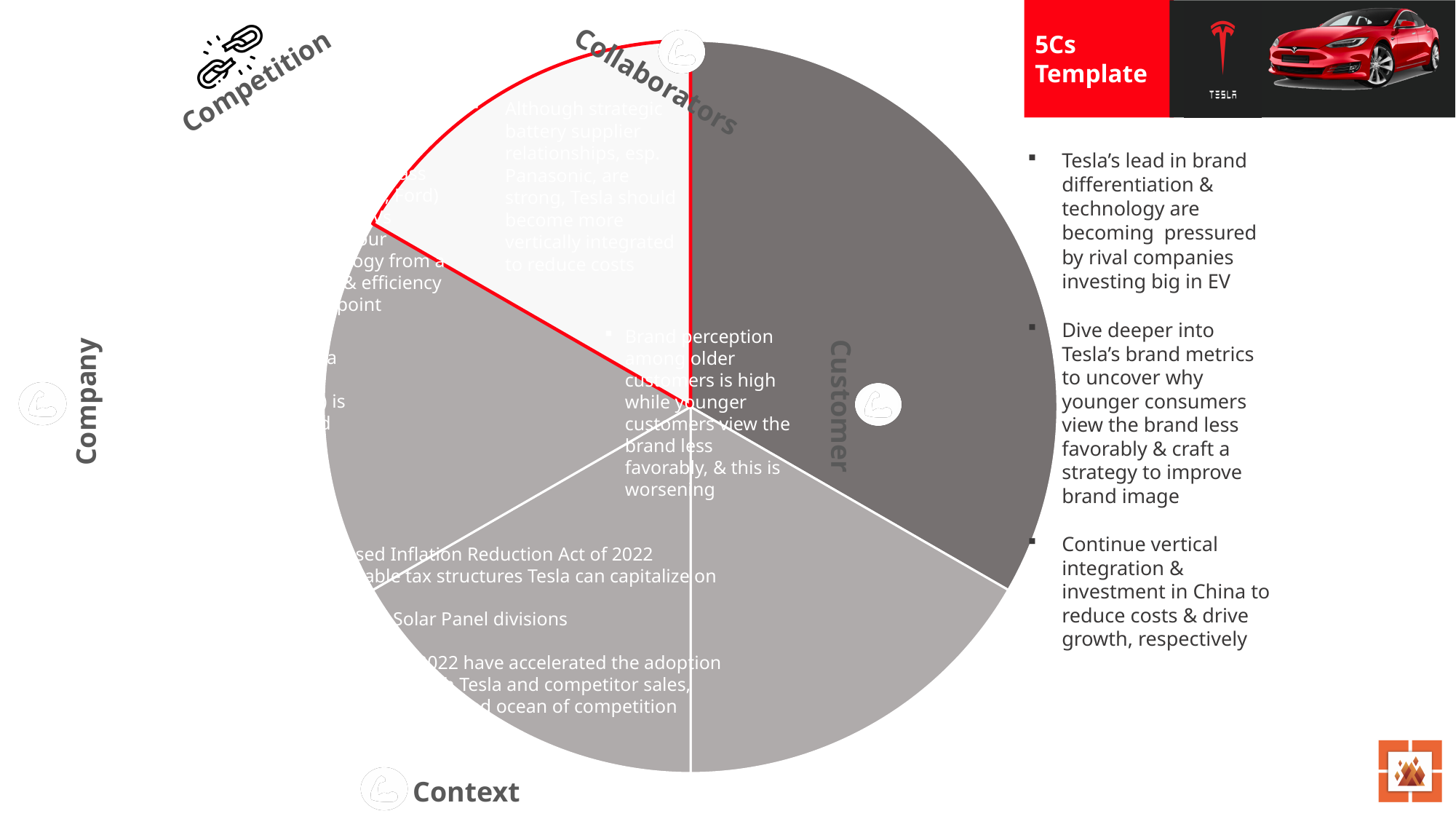
How many slices does the pie chart have? 5 Which slice of the pie chart is the largest? Customer Which is larger in the pie chart, the Customer slice or the Context slice? Customer Which is larger in the pie chart, the Customer slice or the Collaborators slice? Customer Which slice of the pie chart is outlined in red? Collaborators What is the title shown in the red box at the top right of the slide? 5Cs Template What kind of chart is shown on the slide? Pie chart